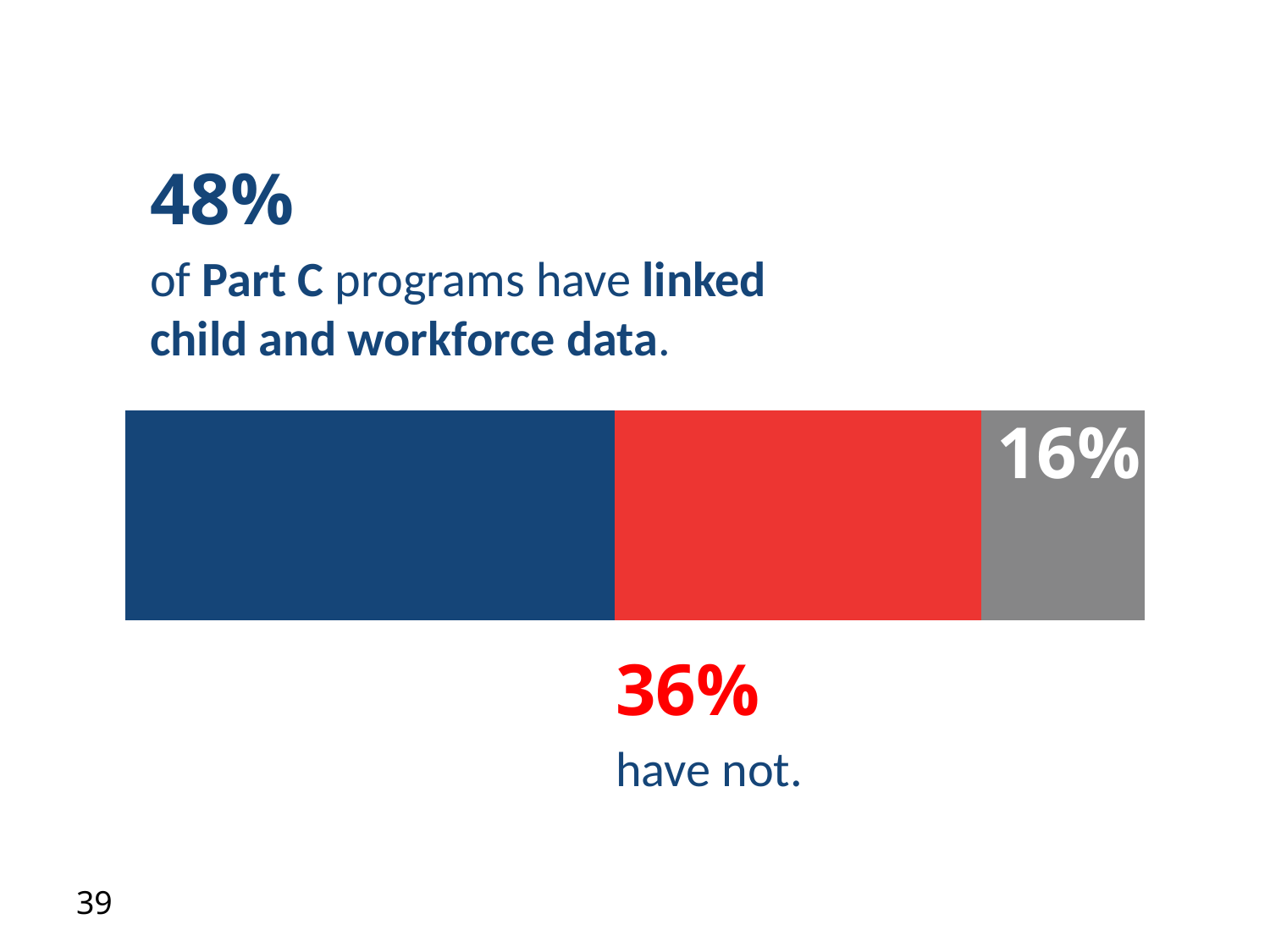
What is the difference in percentage points between programs that have linked data (48%) and those that have not (36%)? 12 percentage points What colour is the segment representing the 48% of programs that have linked child and workforce data? Blue What percentage of Part C programs have not linked child and workforce data? 36% What kind of chart is shown on the slide? Stacked bar chart What colour is the segment representing the 36% of programs that have not linked data? Red What value is printed on the gray segment of the bar? 16% What is the total of the three segments in the stacked bar? 100% How many segments make up the stacked bar? 3 Which is larger: the share of programs that have linked data or the share that have not? Have linked data (48%) Which segment of the bar is the largest? 48% (have linked child and workforce data) Which segment of the bar is the smallest? 16% (gray segment) What percentage of Part C programs have linked child and workforce data? 48%